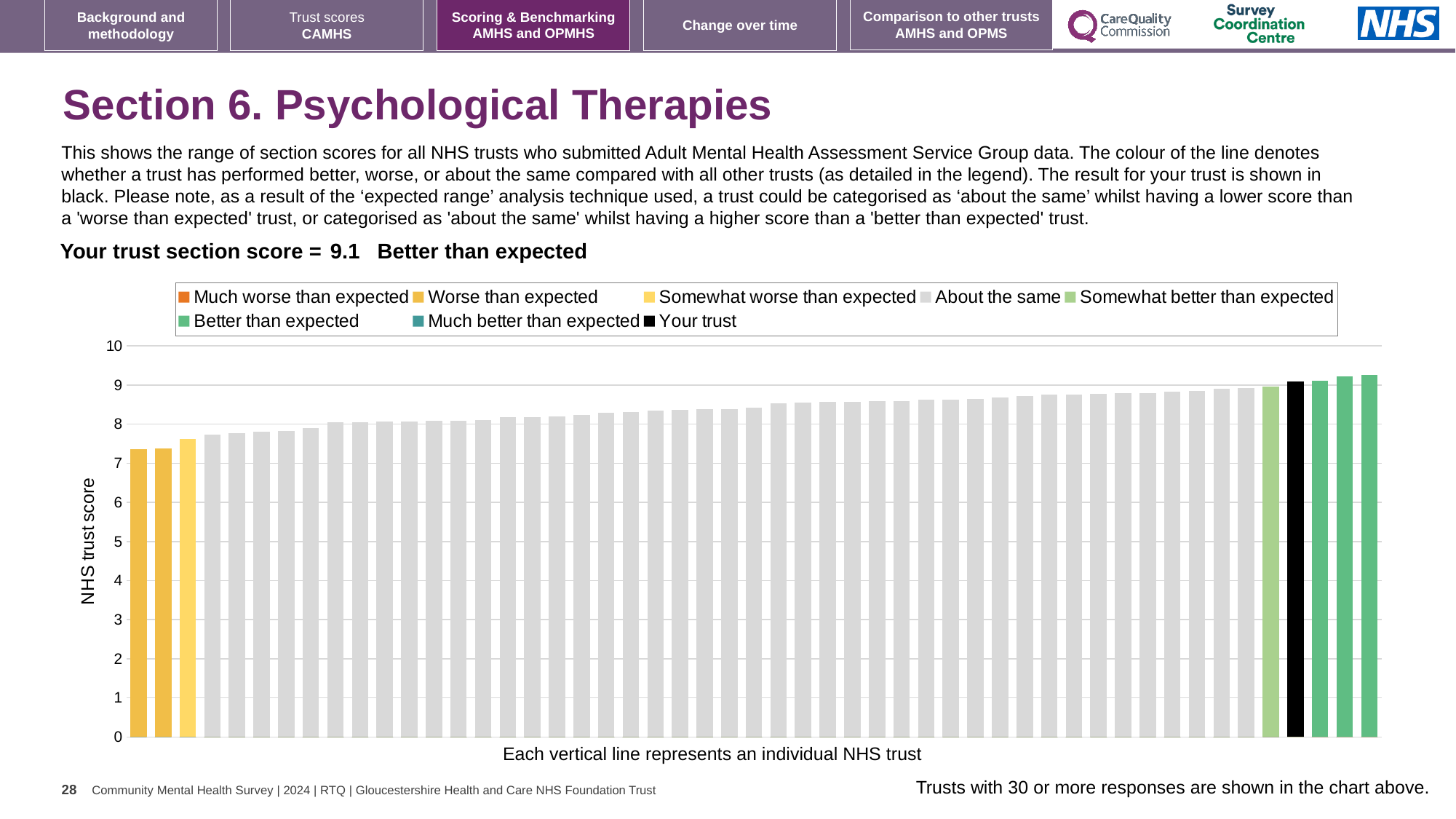
What colour is the bar representing your trust? black What is the section score for your trust shown on the slide? 9.1 Do the bar values rise or fall from left to right along the x axis? rise How many bars are coloured as 'Worse than expected' (dark yellow)? 2 What kind of chart is shown on the slide? bar chart What is the label on the vertical axis of the chart? NHS trust score Which is larger: the value of the black 'Your trust' bar or the value of the rightmost bar? the rightmost bar How many entries does the chart legend list? 8 How many bars are coloured as 'Better than expected' (green), excluding the black 'Your trust' bar? 3 Is the value for the black 'Your trust' bar greater or less than 8? greater Is the value of the rightmost bar greater or less than 10? less Is the value of the leftmost bar greater or less than 8? less